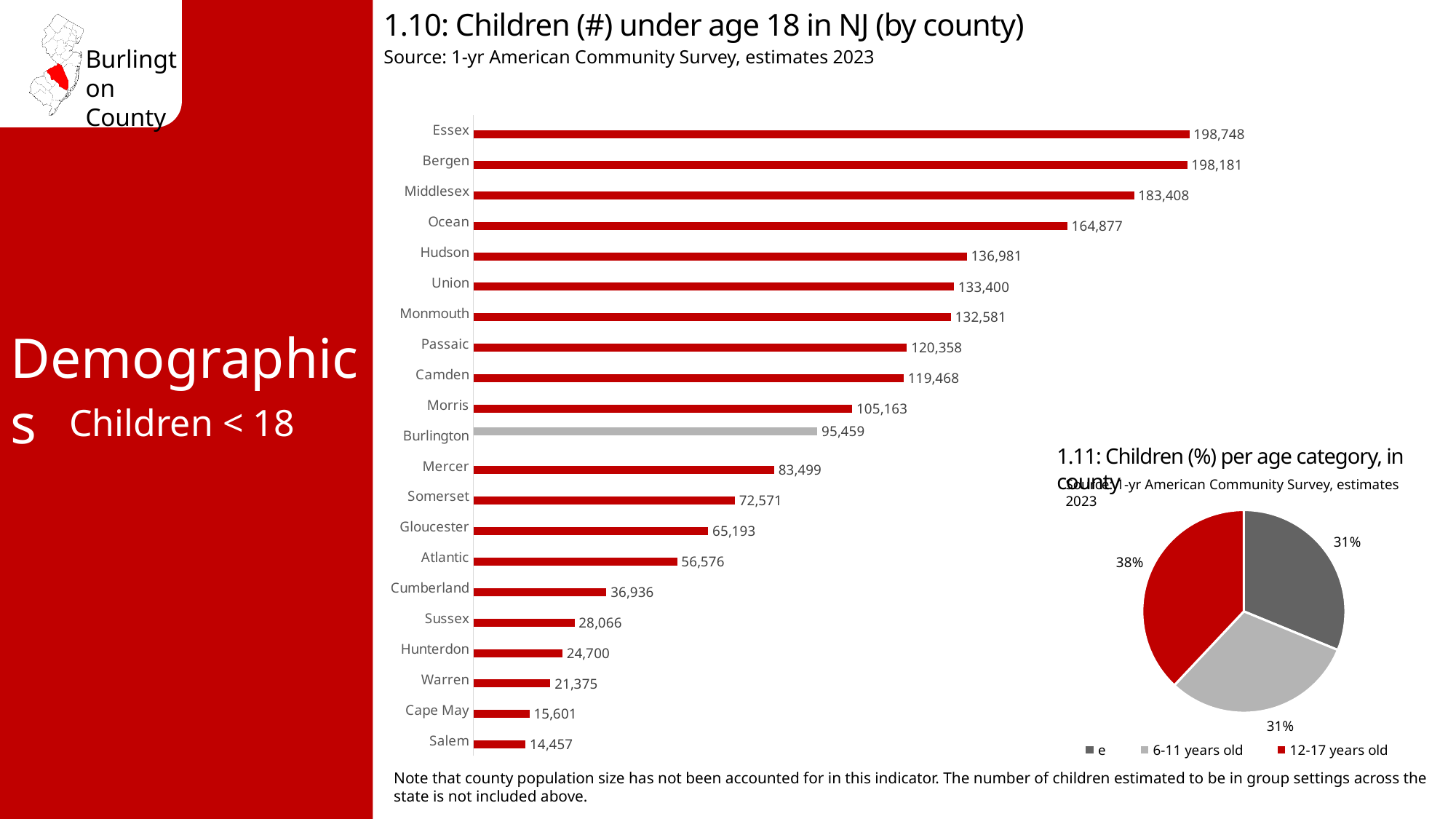
In the chart '1.10: Children (#) under age 18 in NJ (by county)', what is the value for Ocean? 164,877 In the chart '1.10: Children (#) under age 18 in NJ (by county)', which is larger, the value for Passaic or the value for Camden? Passaic How many counties are shown in the chart '1.10: Children (#) under age 18 in NJ (by county)'? 21 What kind of chart is '1.10: Children (#) under age 18 in NJ (by county)'? Bar chart In the chart '1.10: Children (#) under age 18 in NJ (by county)', which county has the lowest value? Salem In the pie chart '1.11: Children (%) per age category, in county', what share is shown for 12-17 years old? 38% In the chart '1.10: Children (#) under age 18 in NJ (by county)', what is the difference between the values for Essex and Bergen? 567 In the chart '1.10: Children (#) under age 18 in NJ (by county)', what is the difference between the values for Burlington and Mercer? 11,960 In the chart '1.10: Children (#) under age 18 in NJ (by county)', which county has the highest value? Essex In the chart '1.10: Children (#) under age 18 in NJ (by county)', which county's bar is shown in gray rather than red? Burlington In the chart '1.10: Children (#) under age 18 in NJ (by county)', what is the value for Burlington? 95,459 In the pie chart '1.11: Children (%) per age category, in county', what share is shown for 6-11 years old? 31%